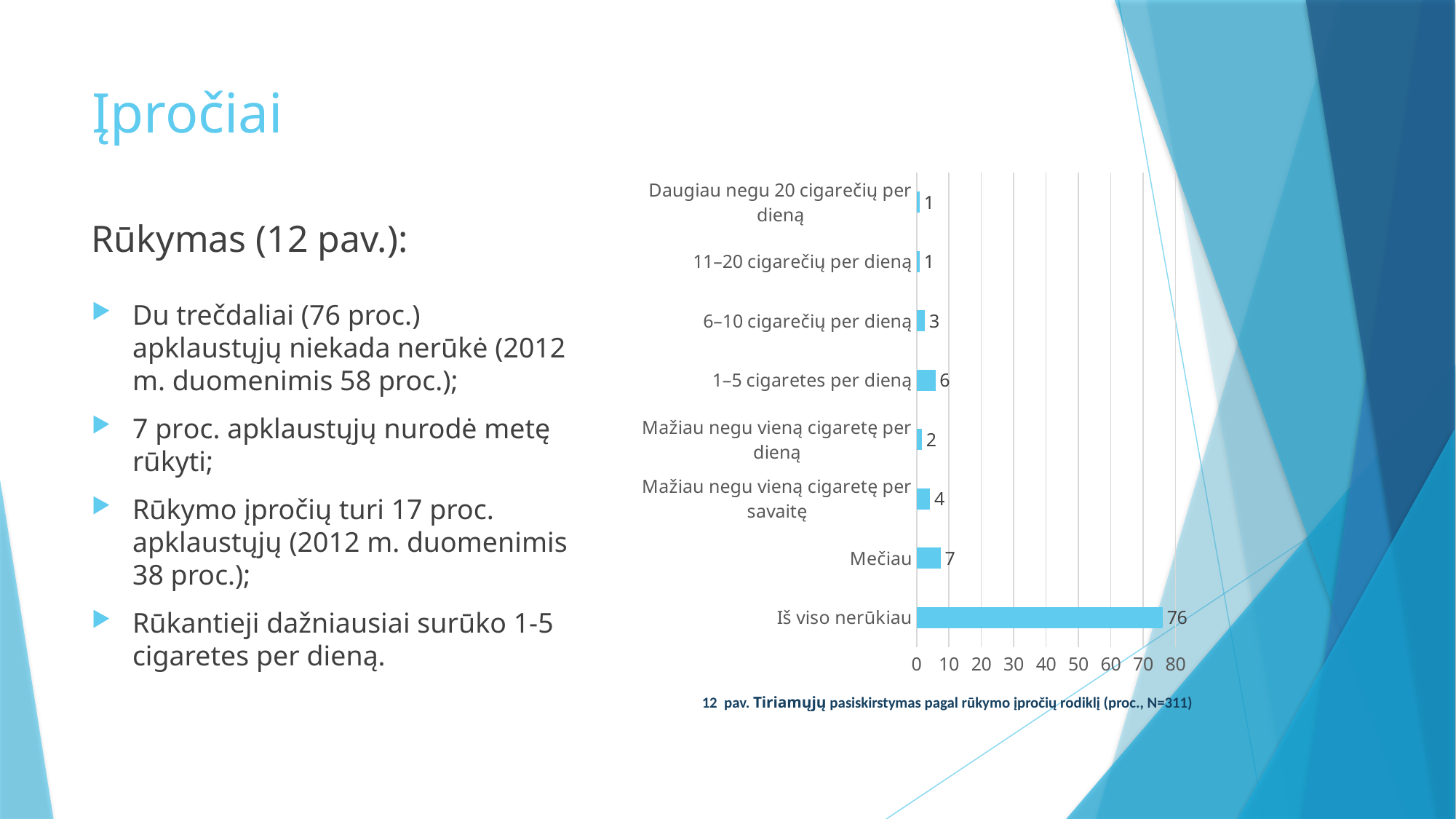
Is the value for "Iš viso nerūkiau" greater or less than 70? greater How many categories are shown in the chart? 8 What is the difference between the values for "1–5 cigaretes per dieną" and "6–10 cigarečių per dieną"? 3 What is the value for "Mečiau"? 7 What is the sample size (N) stated in the chart caption? N=311 Which is larger, the value for "Mažiau negu vieną cigaretę per savaitę" or the value for "Mažiau negu vieną cigaretę per dieną"? Mažiau negu vieną cigaretę per savaitę What is the value for "Mažiau negu vieną cigaretę per savaitę"? 4 What is the value for "1–5 cigaretes per dieną"? 6 What is the difference between the values for "Iš viso nerūkiau" and "Mečiau"? 69 Which category has the highest value? Iš viso nerūkiau What is the value for "Iš viso nerūkiau"? 76 What kind of chart is shown on the slide? bar chart